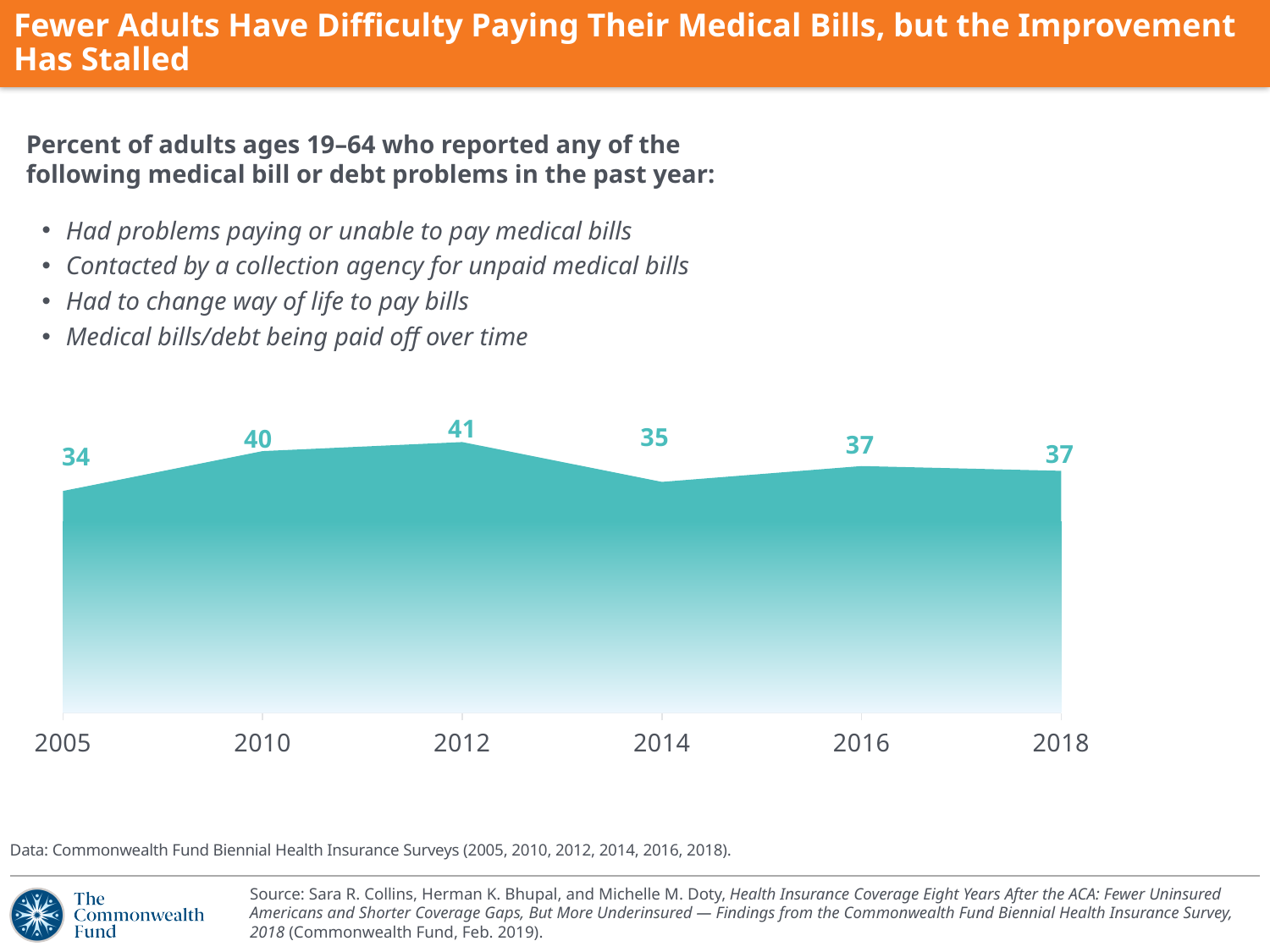
Which year has the lowest value? 2005 What is the difference between the values for 2012 and 2014? 6 What is the value for 2005? 34 Did the value rise or fall from 2005 to 2012? Rise What is the difference between the values for 2018 and 2005? 3 What is the value for 2014? 35 Which is larger, the value for 2010 or the value for 2016? 2010 Which year has the highest value? 2012 What kind of chart is shown on the slide? Area chart What is the value for 2012? 41 How many years are plotted on the chart? 6 What is the value for 2018? 37